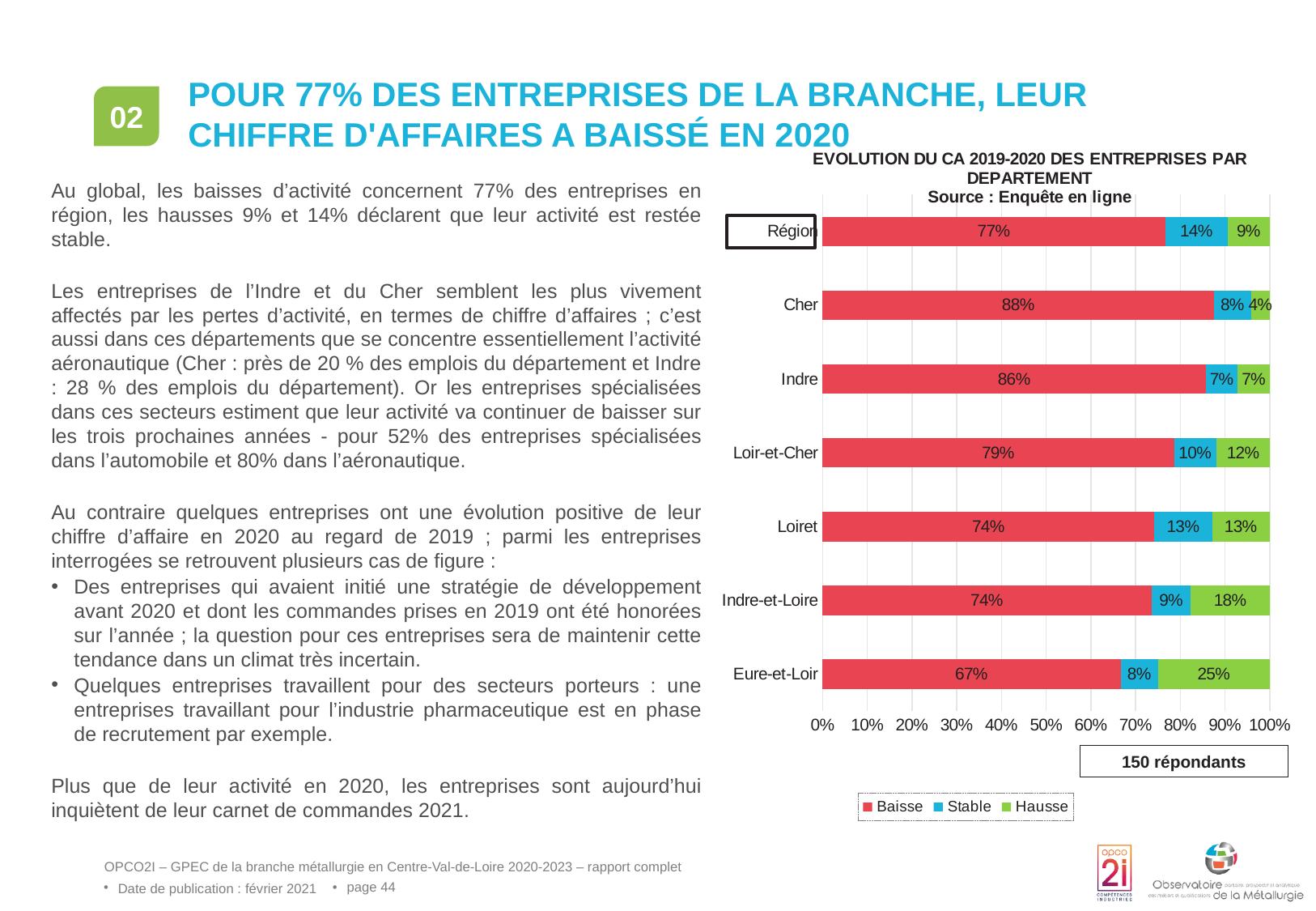
What is the Hausse value for Indre-et-Loire? 18% What is the source stated in the chart title? Enquête en ligne Which category has the lowest Baisse value? Eure-et-Loir Which is larger, the Hausse value for Loiret or the Hausse value for Loir-et-Cher? Loiret Which department has the highest Baisse value? Cher What is the Stable value for Région? 14% What is the difference between the Baisse values for Cher and Eure-et-Loir? 21% How many series does the legend list? 3 How many categories are shown on the y axis of the chart? 7 What is the Baisse value for Cher? 88% What is the Hausse value for Eure-et-Loir? 25% What kind of chart is shown on the slide? Stacked bar chart